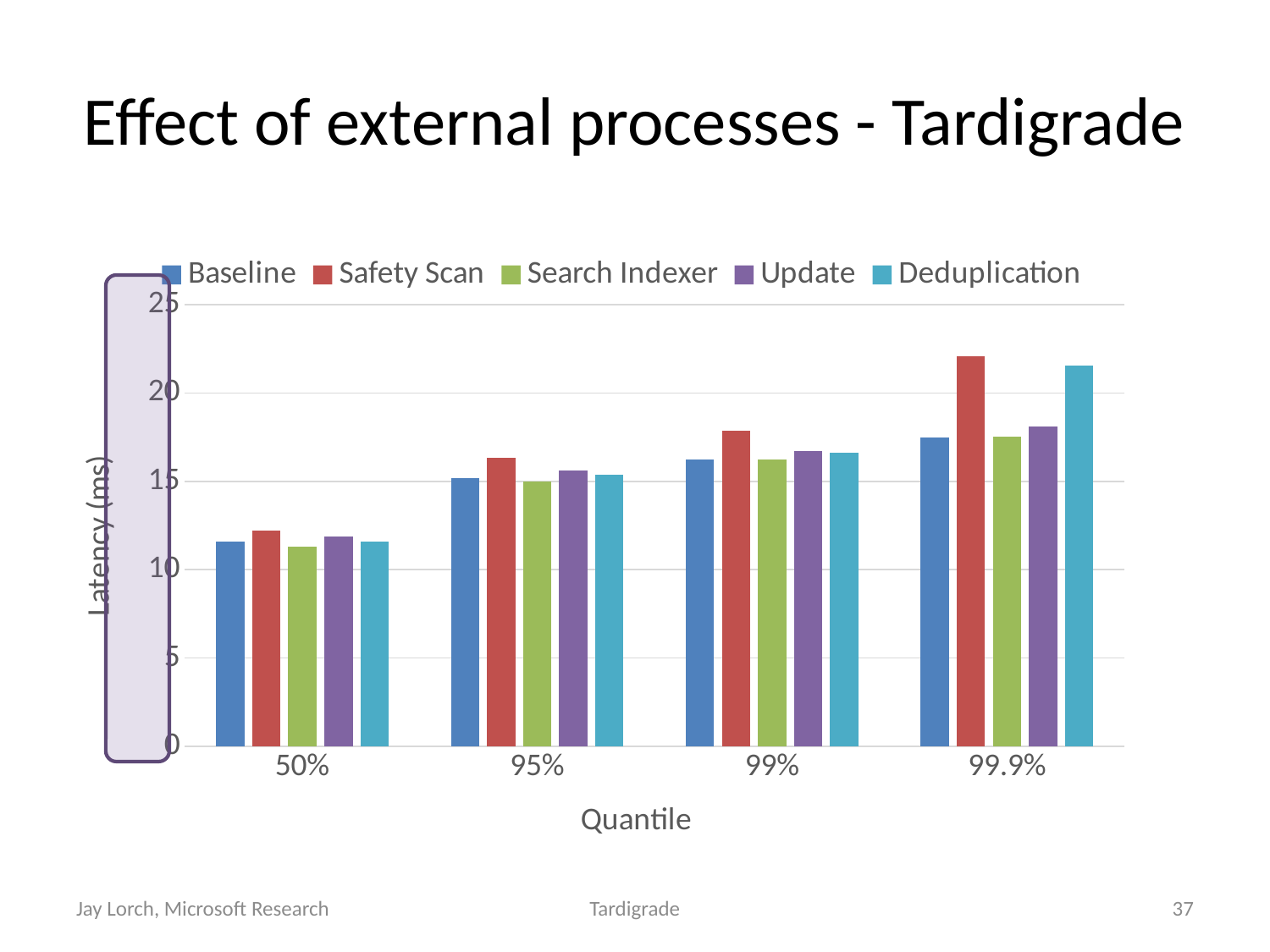
Is the Update value at the 99% quantile greater or less than 15? greater Does the Baseline latency rise or fall as the quantile increases from 50% to 99.9%? rise Is the Baseline value at the 99.9% quantile greater or less than 20? less How many quantile categories are shown on the x axis? 4 Which series has the highest latency at the 95% quantile? Safety Scan Is the Baseline value at the 50% quantile greater or less than 10? greater At the 99.9% quantile, which is larger: Deduplication or Search Indexer? Deduplication Which series has the highest latency at the 99% quantile? Safety Scan What is the label on the y axis? Latency (ms) How many series does the legend list? 5 What kind of chart is shown on the slide? bar chart